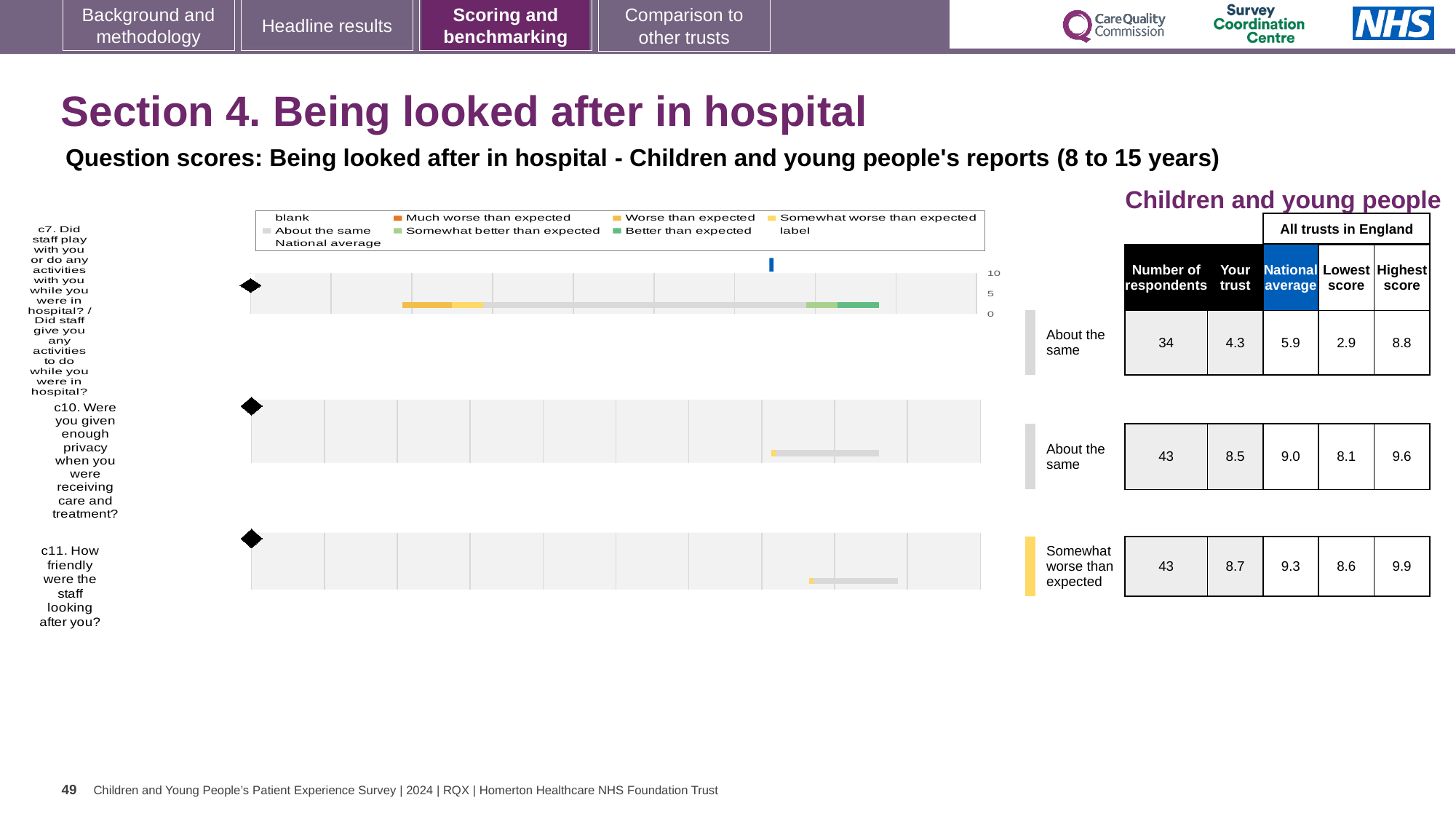
What is the highest score across all trusts in England for question c7? 8.8 How many respondents answered question c7 (Did staff play with you or do any activities with you while you were in hospital?)? 34 What is the lowest score across all trusts in England for question c10? 8.1 For question c7, how much higher is the national average than the 'Your trust' score? 1.6 How many questions are shown on this slide? 3 For question c11, which is larger: the 'Your trust' score or the national average? National average What is the 'Your trust' score for question c10 (Were you given enough privacy when you were receiving care and treatment?)? 8.5 What kind of chart is used to show the question scores on this slide? Bar chart What benchmark category is shown for question c11? Somewhat worse than expected Which question has the highest 'Your trust' score? c11. How friendly were the staff looking after you? Which question has the lowest 'Lowest score' across all trusts in England? c7. Did staff play with you or do any activities with you while you were in hospital? What is the national average score for question c11 (How friendly were the staff looking after you?)? 9.3